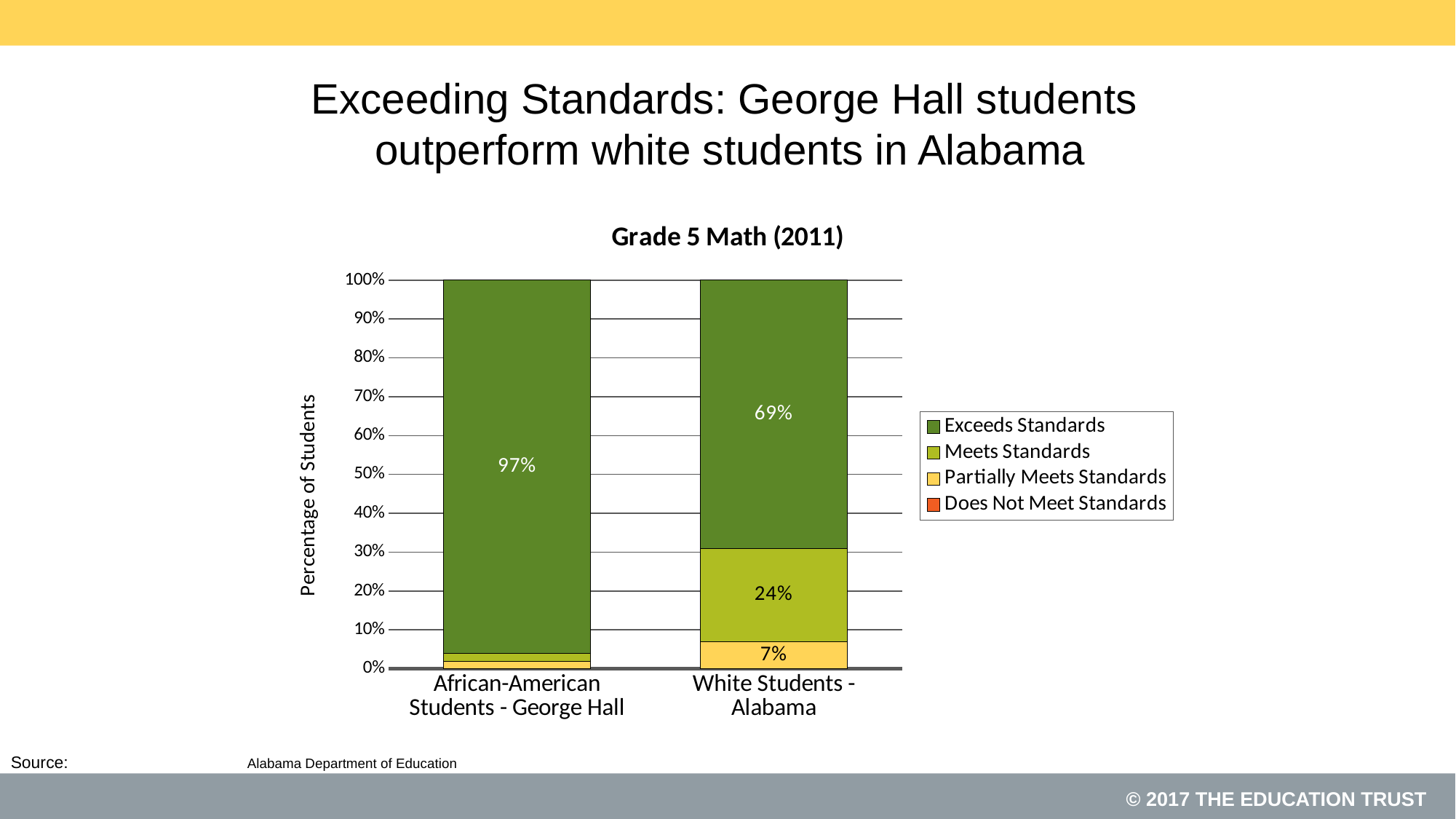
What is the title of the chart? Grade 5 Math (2011) How many series does the legend list? 4 How many percentage points higher is the Exceeds Standards share for African-American Students - George Hall than for White Students - Alabama? 28 percentage points What kind of chart is shown on the slide? Stacked bar chart Which group has the larger Exceeds Standards share: African-American Students - George Hall or White Students - Alabama? African-American Students - George Hall How many student groups are shown on the x axis? 2 Which category is the largest segment of the White Students - Alabama bar? Exceeds Standards What percentage of White Students - Alabama are in the Partially Meets Standards category? 7% What percentage of White Students - Alabama are in the Meets Standards category? 24% What percentage of White Students - Alabama are in the Exceeds Standards category? 69% Is the Meets Standards share for African-American Students - George Hall greater or less than 10%? less What percentage of African-American Students - George Hall are in the Exceeds Standards category? 97%